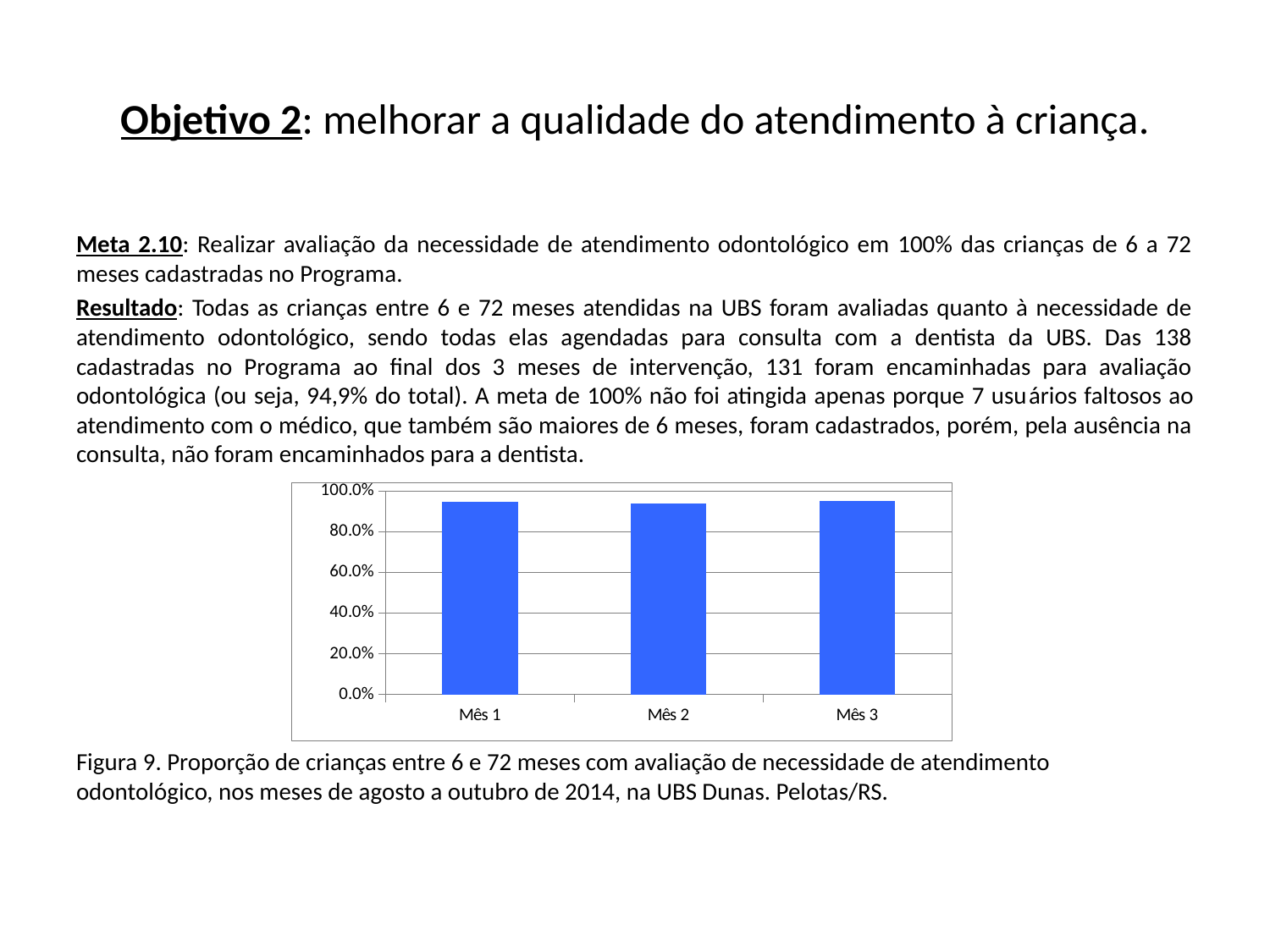
Is the value for Mês 2 greater or less than 100.0%? less Is the value for Mês 3 greater or less than 60.0%? greater Is the value for Mês 1 greater or less than 80.0%? greater How many bars (categories) does the chart show? 3 What kind of chart is shown on the slide? bar chart What is the highest tick value shown on the y axis of the chart? 100.0% What are the category labels on the x axis of the chart? Mês 1, Mês 2, Mês 3